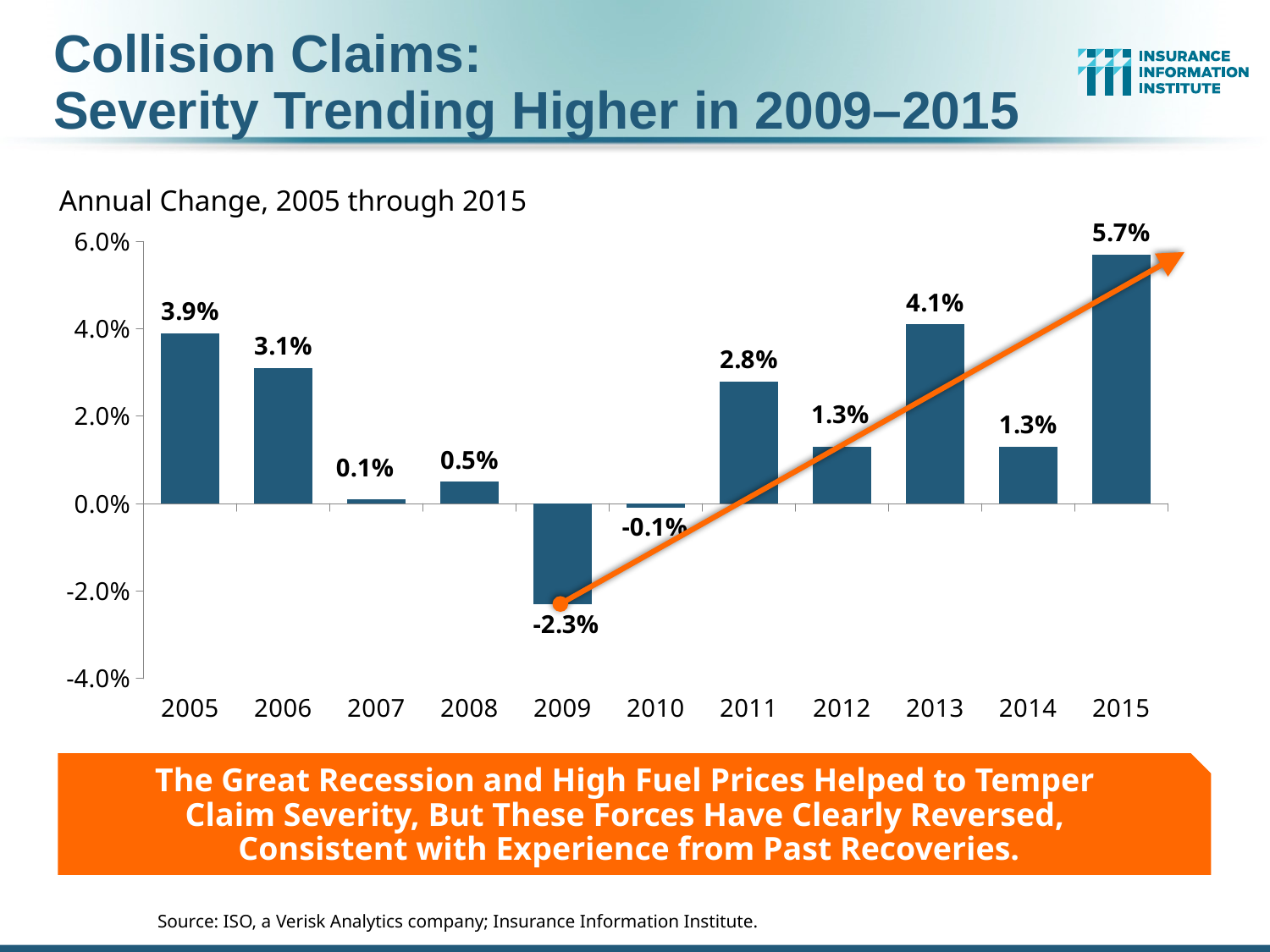
Which year has the lowest annual change? 2009 What kind of chart is shown on the slide? Bar chart Which year has the highest annual change? 2015 What is the annual change shown for 2011? 2.8% What is the annual change in collision claim severity for 2015? 5.7% Do the annual change values generally rise or fall from 2009 to 2015? Rise What is the difference between the annual change in 2015 and in 2013? 1.6% What is the annual change shown for 2009? -2.3% Which year has the larger annual change, 2005 or 2006? 2005 What is the subtitle printed above the chart? Annual Change, 2005 through 2015 Is the value for 2013 greater or less than 4.0%? greater How many years are shown on the x axis of the chart? 11